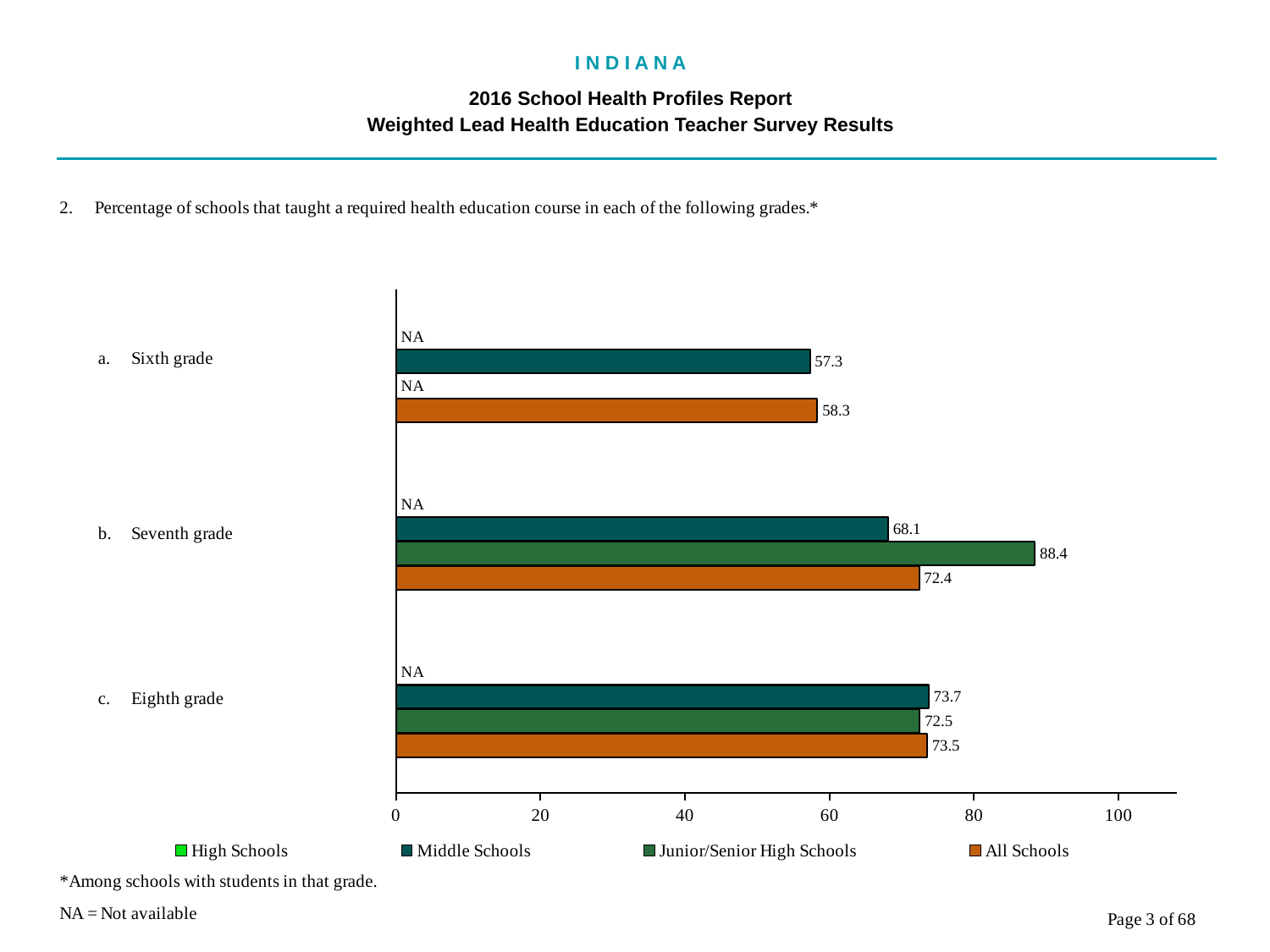
What is the value for All Schools in Seventh grade? 72.4 Which grade has the highest value for Middle Schools? Eighth grade What value is shown for High Schools in Sixth grade? NA How many grade categories are shown on the chart? 3 Which is larger in Eighth grade: the Middle Schools value or the All Schools value? Middle Schools What kind of chart is shown on the slide? Bar chart What is the value for Junior/Senior High Schools in Eighth grade? 72.5 What is the value for Middle Schools in Sixth grade? 57.3 How many series does the legend list? 4 What is the difference between the Junior/Senior High Schools value and the Middle Schools value in Seventh grade? 20.3 What is the value for Junior/Senior High Schools in Seventh grade? 88.4 Which grade has the lowest value for All Schools? Sixth grade